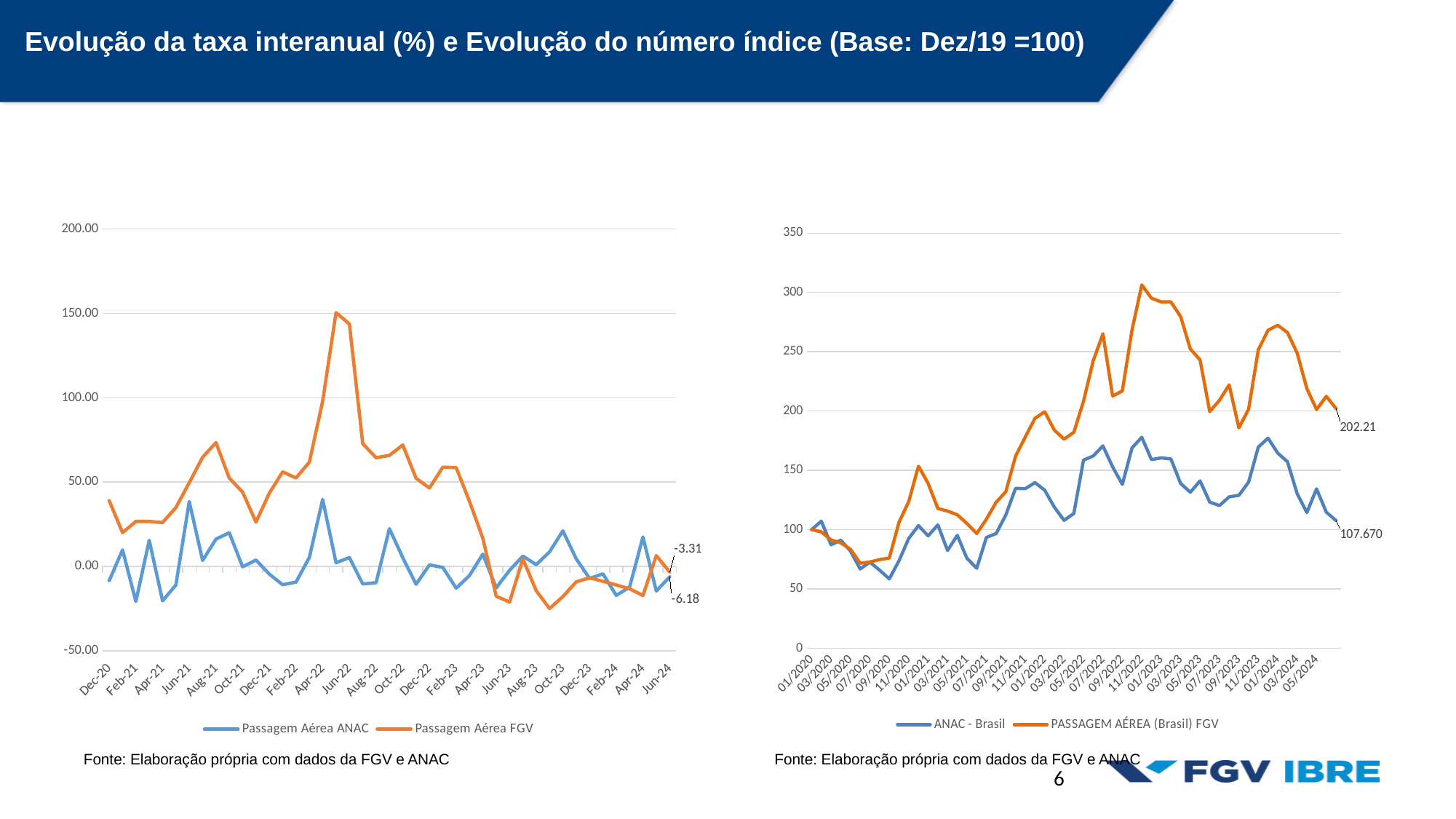
In the left chart (Evolução da taxa interanual), is the peak value of Passagem Aérea FGV greater or less than 100.00? greater In the left chart, what is the final data label shown for Passagem Aérea FGV? -3.31 In the right chart (Evolução do número índice), what is the final data label shown for PASSAGEM AÉREA (Brasil) FGV? 202.21 In the right chart, which series has the higher final labelled value, ANAC - Brasil or PASSAGEM AÉREA (Brasil) FGV? PASSAGEM AÉREA (Brasil) FGV What kind of chart is the left chart (Evolução da taxa interanual)? Line chart In the right chart (Evolução do número índice), what is the final data label shown for ANAC - Brasil? 107.670 How many series does the legend of the left chart list? 2 In the left chart (Evolução da taxa interanual), is the highest value of Passagem Aérea ANAC greater or less than 50.00? less What are the two legend entries of the right chart (Evolução do número índice)? ANAC - Brasil and PASSAGEM AÉREA (Brasil) FGV In the right chart, is the peak value of PASSAGEM AÉREA (Brasil) FGV greater or less than 250? greater In the right chart, which series reaches the highest peak? PASSAGEM AÉREA (Brasil) FGV In the right chart, what is the difference between the final labelled values of PASSAGEM AÉREA (Brasil) FGV and ANAC - Brasil? 94.54